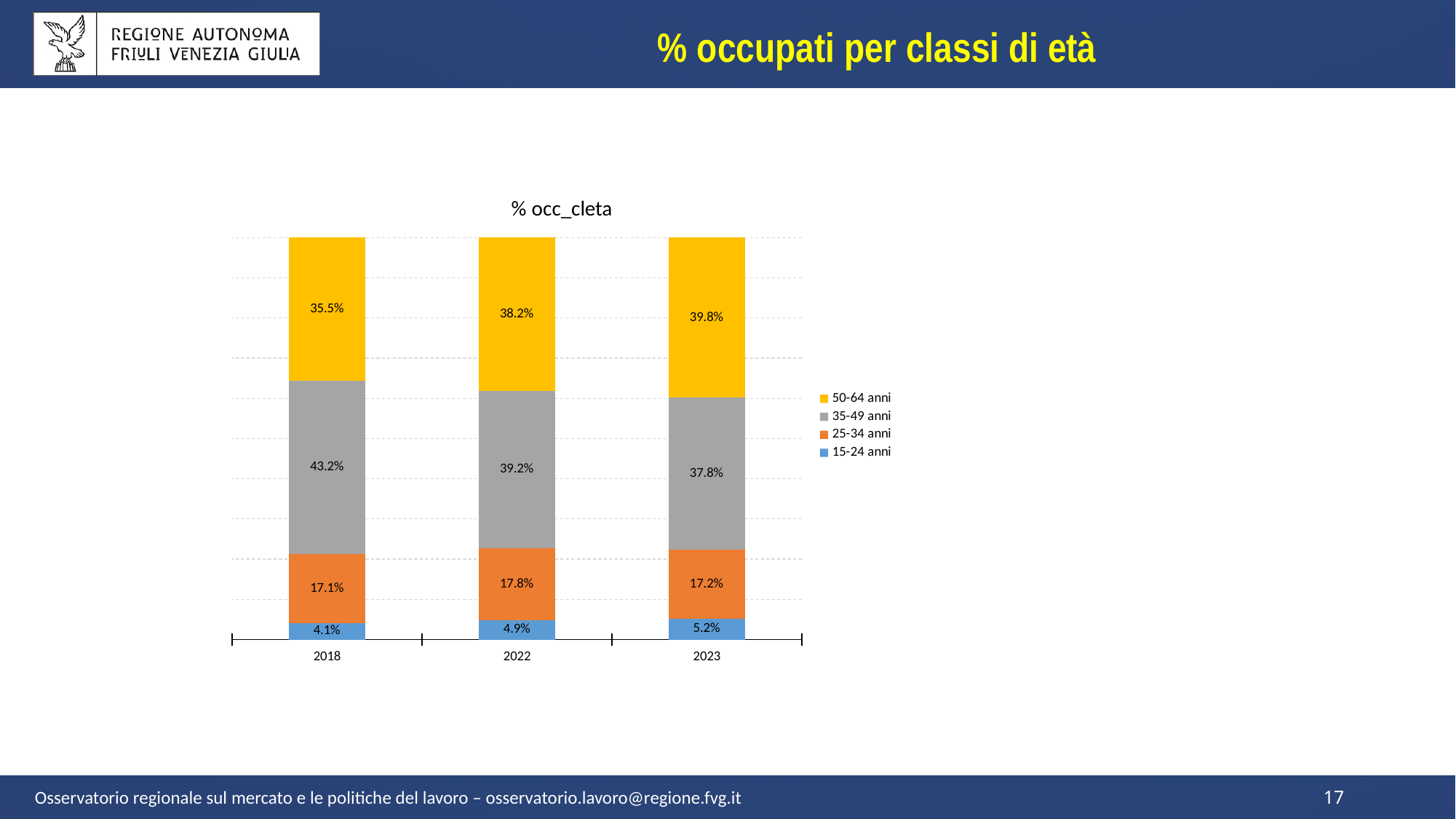
What is the value for 50-64 anni in 2018? 35.5% In 2022, which is larger: the 50-64 anni segment or the 35-49 anni segment? 35-49 anni In which year is the share of 15-24 anni lowest? 2018 How many series does the legend list? 4 What is the value for 35-49 anni in 2022? 39.2% What is the difference between the 35-49 anni value in 2018 and in 2023? 5.4 percentage points Does the share of 50-64 anni rise or fall from 2018 to 2023? rise What kind of chart is shown? stacked bar chart Does the share of 35-49 anni rise or fall from 2018 to 2023? fall What is the value for 15-24 anni in 2023? 5.2% In which year is the share of 50-64 anni highest? 2023 How many years are shown on the x axis? 3